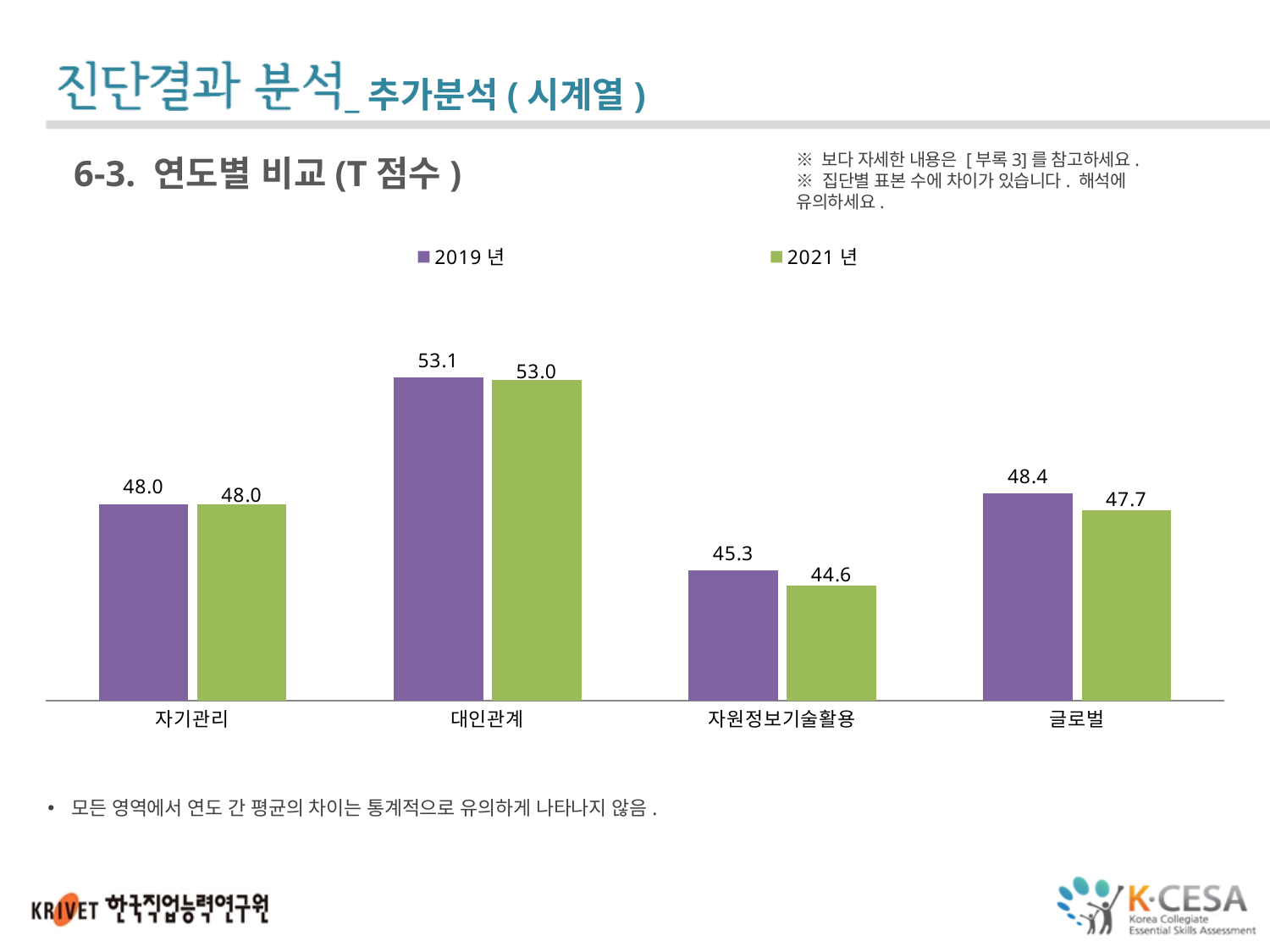
What is the 2021 년 value for 글로벌? 47.7 What is the 2019 년 value for 대인관계? 53.1 Which is larger for 대인관계, the 2019 년 value or the 2021 년 value? 2019 년 Which colour represents 2021 년 in the chart? green What is the difference between the 2019 년 and 2021 년 values for 글로벌? 0.7 What kind of chart is shown on the slide? bar chart How many series does the legend list? 2 How many categories are shown on the x axis? 4 Which category has the lowest 2021 년 value? 자원정보기술활용 What is the difference between the 2019 년 and 2021 년 values for 자원정보기술활용? 0.7 Which category has the highest 2019 년 value? 대인관계 What is the 2021 년 value for 자원정보기술활용? 44.6